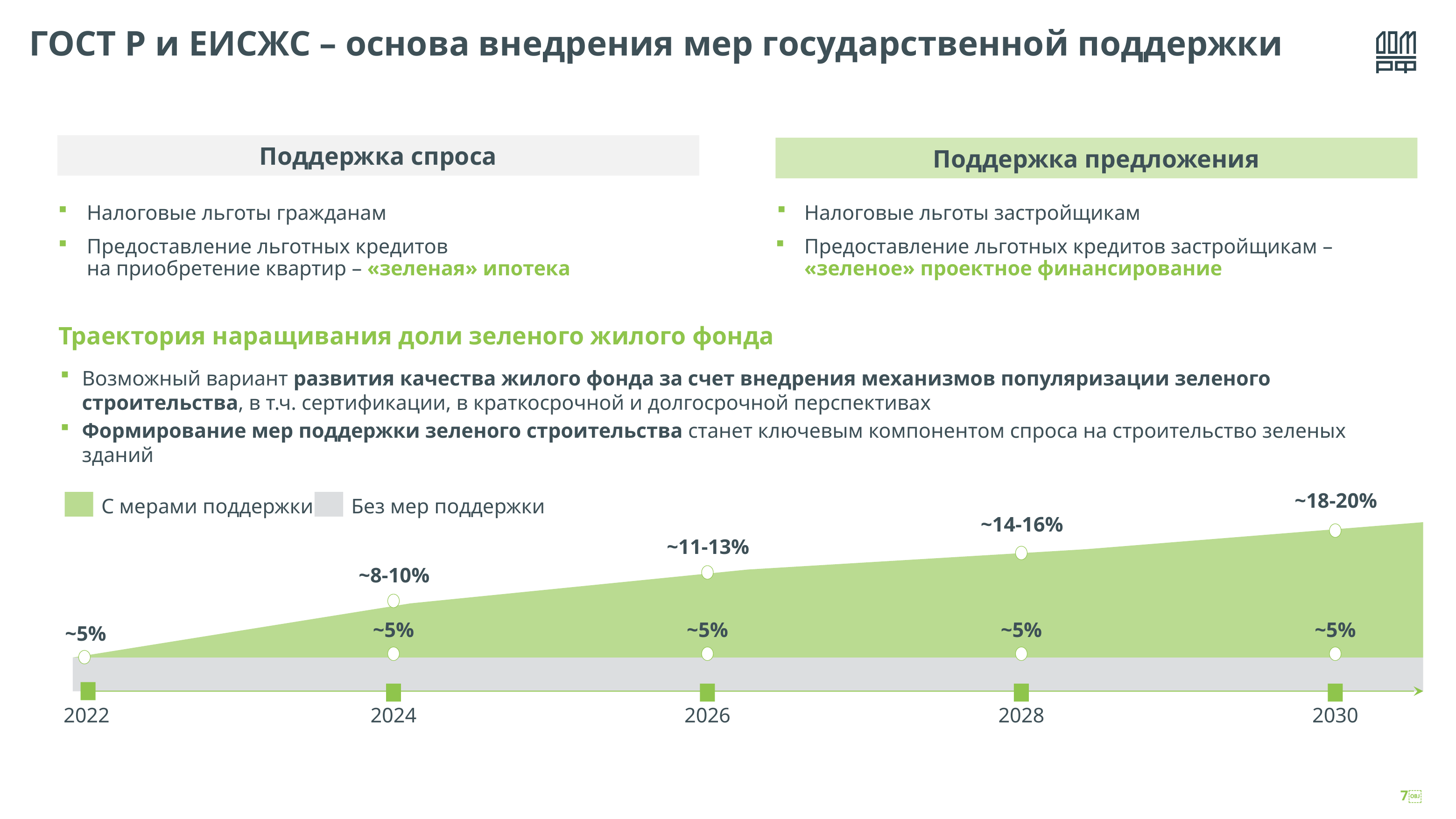
Does the 'С мерами поддержки' series rise or fall from 2022 to 2030? Rise Which is larger for 'С мерами поддержки': the value in 2028 or the value in 2024? 2028 What kind of chart is shown at the bottom of the slide? Area chart What are the two series named in the chart legend? С мерами поддержки; Без мер поддержки What value is labelled for 'С мерами поддержки' in 2026? ~11-13% What value is labelled for 'Без мер поддержки' in 2028? ~5% What value is labelled for 'С мерами поддержки' in 2030? ~18-20% How many years are marked on the x axis of the chart? 5 In which year is the 'С мерами поддержки' series at its lowest labelled value? 2022 How many series does the chart legend list? 2 What value is labelled for 'С мерами поддержки' in 2024? ~8-10% In which year does the 'С мерами поддержки' series reach its highest labelled value? 2030